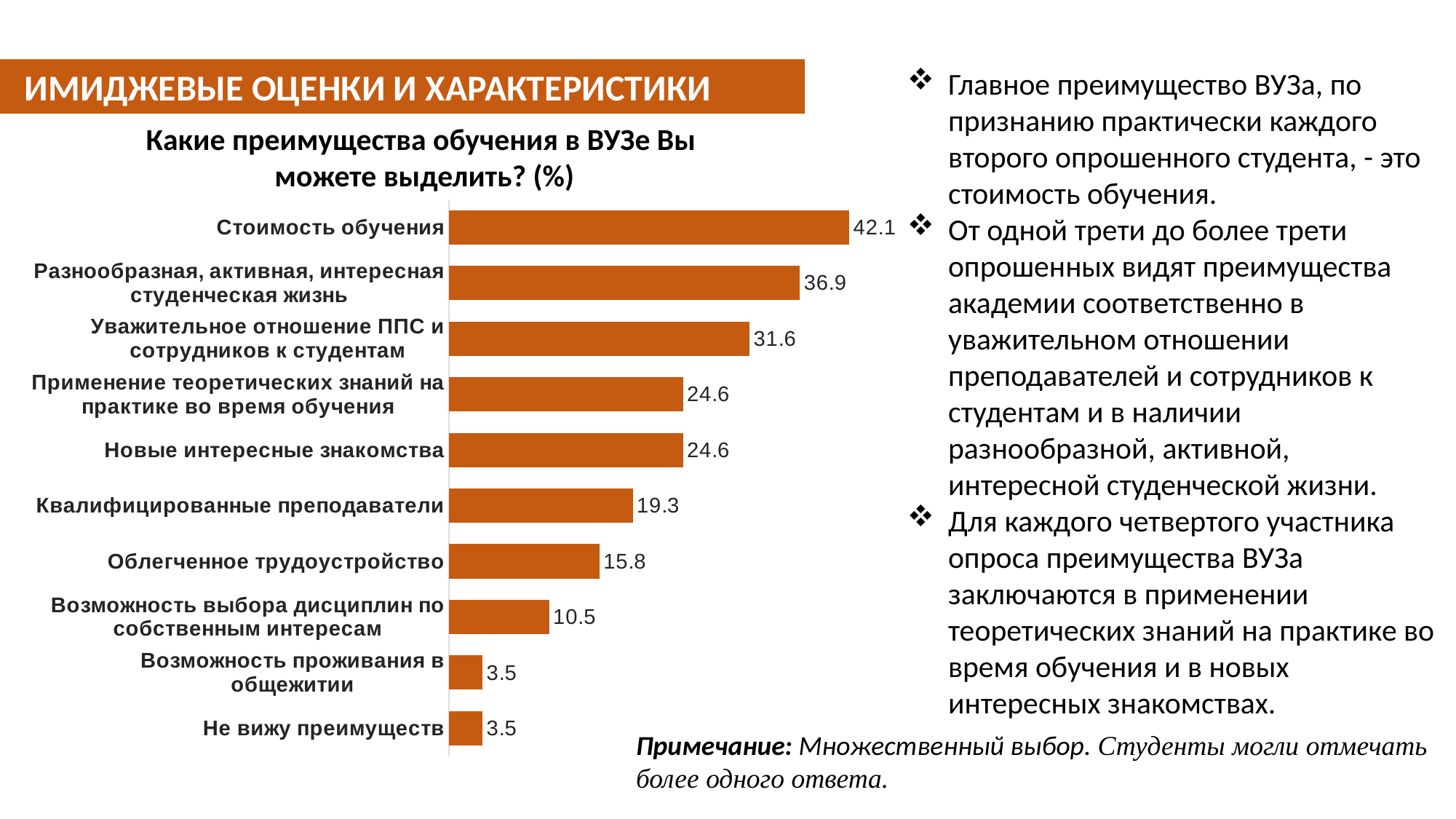
What is the difference between the values for "Квалифицированные преподаватели" and "Облегченное трудоустройство"? 3.5 What is the lowest value shown in the chart? 3.5 What is the value for "Облегченное трудоустройство"? 15.8 How many categories are shown in the chart? 10 Which category has the highest value? Стоимость обучения What is the value for "Возможность выбора дисциплин по собственным интересам"? 10.5 What is the value for "Квалифицированные преподаватели"? 19.3 What is the title of the chart? Какие преимущества обучения в ВУЗе Вы можете выделить? (%) Which is larger: the value for "Уважительное отношение ППС и сотрудников к студентам" or the value for "Новые интересные знакомства"? Уважительное отношение ППС и сотрудников к студентам What is the value for "Стоимость обучения"? 42.1 What type of chart is shown on the slide? Bar chart What is the difference between the values for "Стоимость обучения" and "Разнообразная, активная, интересная студенческая жизнь"? 5.2